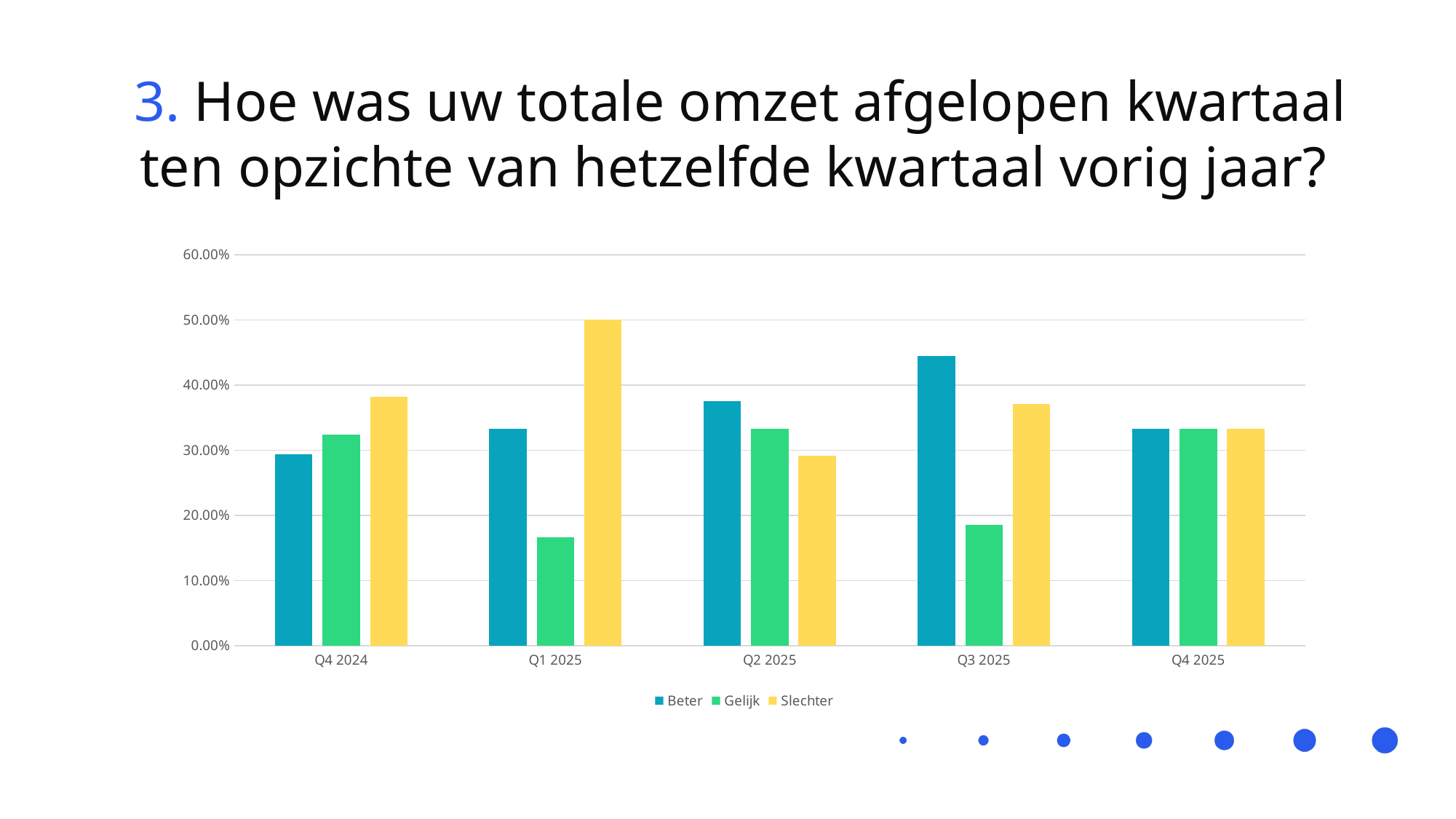
Is the value for Gelijk in Q3 2025 greater or less than 20.00%? less What kind of chart is shown on the slide? bar chart Which quarter has the highest value for Beter? Q3 2025 How many series does the legend list? 3 Is the value for Slechter in Q1 2025 greater or less than 40.00%? greater Which quarter has the highest value for Slechter? Q1 2025 Which legend entry is shown in yellow? Slechter Which quarter has the lowest value for Gelijk? Q1 2025 In Q4 2024, which is larger: Beter or Slechter? Slechter How many quarters are shown on the x axis? 5 In Q2 2025, which is larger: Beter or Slechter? Beter